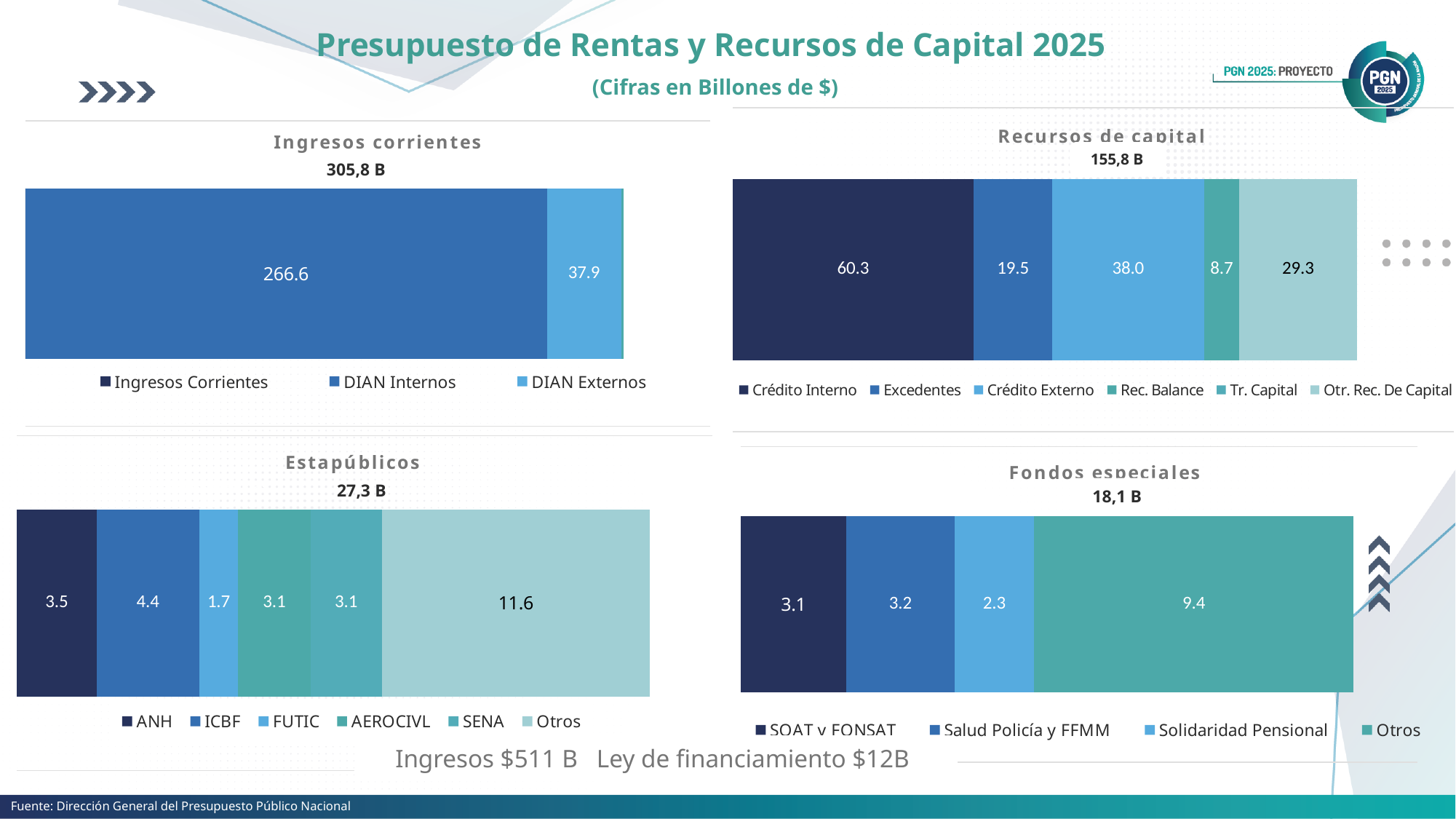
What kind of chart is the Estapúblicos chart? Stacked bar chart How many series does the legend of the Fondos especiales chart list? 4 In the Fondos especiales chart, what is the value for Otros? 9.4 In the Recursos de capital chart, which segment is the largest? Crédito Interno In the Estapúblicos chart, what is the difference between the ICBF value and the ANH value? 0.9 In the Ingresos corrientes chart, what is the value for DIAN Externos? 37.9 In the Estapúblicos chart, which segment is the smallest? FUTIC In the Estapúblicos chart, what is the value for ICBF? 4.4 What total is printed above the Recursos de capital bar? 155,8 B In the Recursos de capital chart, what is the value for Crédito Externo? 38.0 In the Recursos de capital chart, what is the value for Crédito Interno? 60.3 In the Ingresos corrientes chart, what is the value for DIAN Internos? 266.6